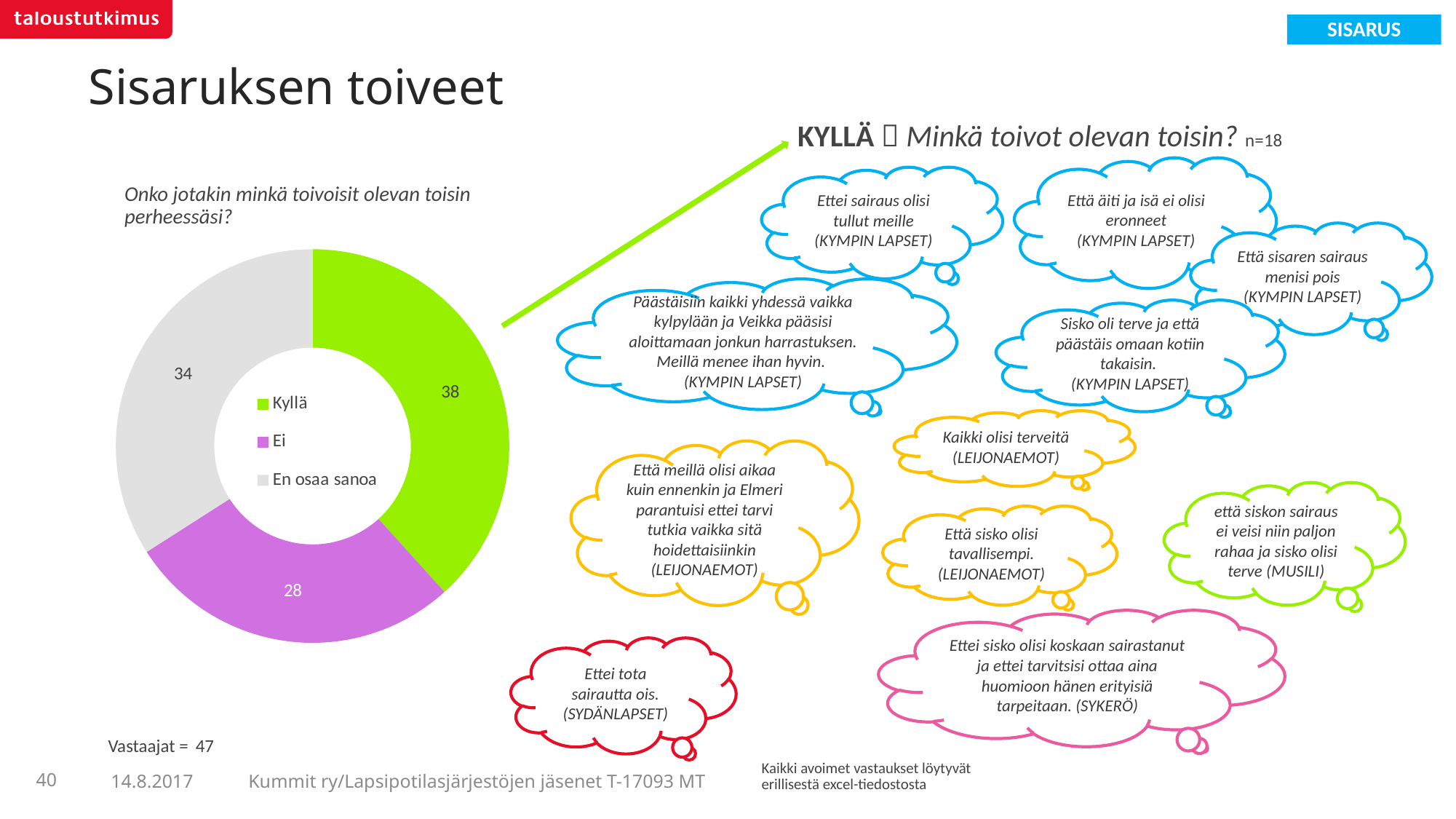
Which is larger in the doughnut chart, Kyllä or En osaa sanoa? Kyllä What is the total of the three values shown in the doughnut chart? 100 How many categories does the doughnut chart show? 3 What is the value for Kyllä in the doughnut chart? 38 What is the value for En osaa sanoa in the doughnut chart? 34 What kind of chart is shown on the slide? doughnut chart Which category has the highest value in the doughnut chart? Kyllä Which category has the lowest value in the doughnut chart? Ei Which colour represents Ei in the doughnut chart? purple What is the value for Ei in the doughnut chart? 28 What is the difference between the values for En osaa sanoa and Ei in the doughnut chart? 6 What is the difference between the values for Kyllä and Ei in the doughnut chart? 10